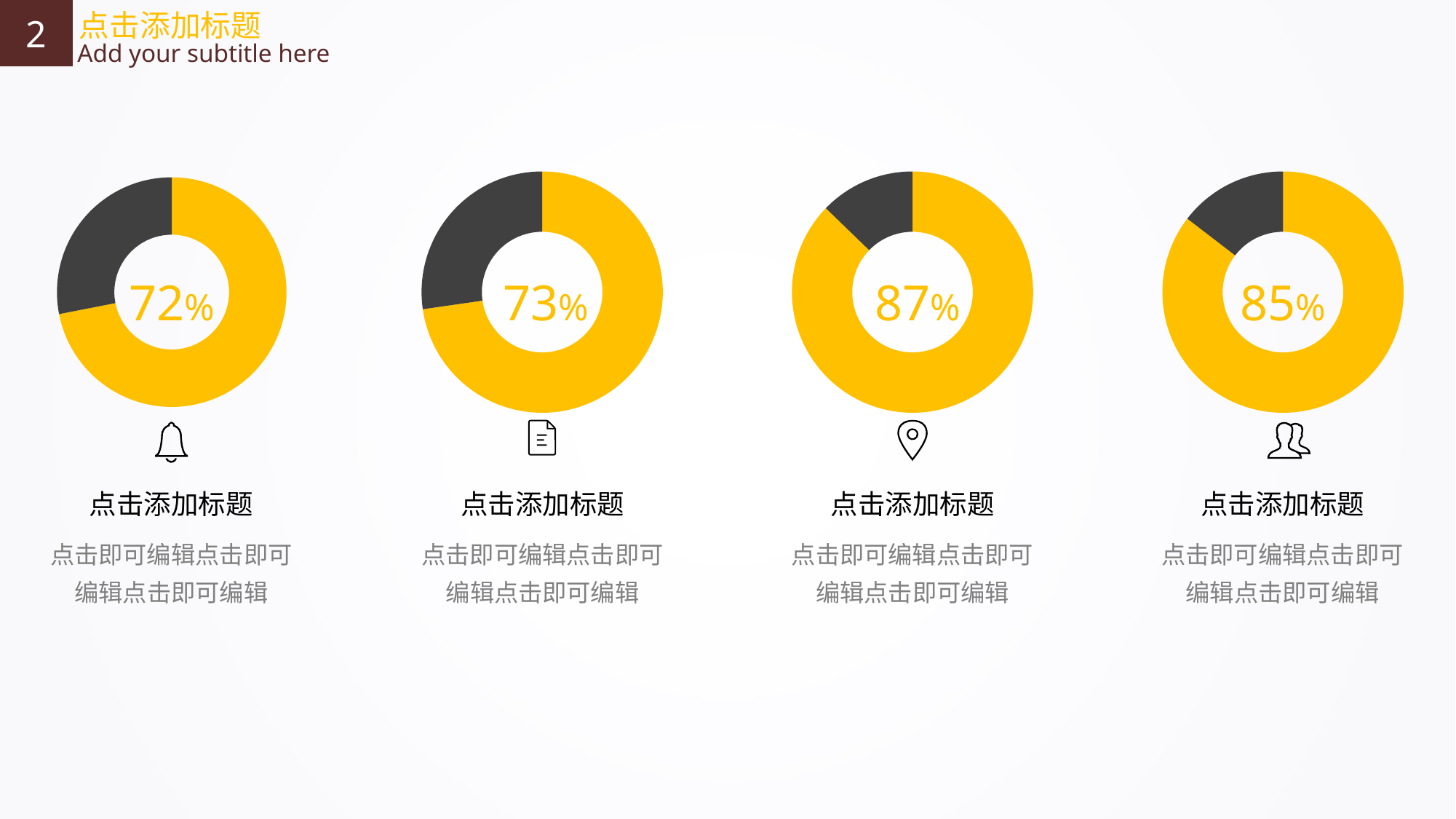
What is the difference between the percentage in the rightmost donut chart and the percentage in the second donut chart from the left? 12% Which donut chart shows the highest percentage? The third from the left (87%) In the leftmost donut chart, what share does the dark grey segment represent? 28% Which donut chart shows the lowest percentage? The leftmost (72%) What percentage is shown in the center of the third donut chart from the left? 87% What percentage is shown in the center of the rightmost donut chart? 85% What is the difference between the percentage in the third donut chart and the percentage in the leftmost donut chart? 15% What kind of chart is used on this slide? Donut (pie) chart Which is larger: the percentage in the third donut chart or the percentage in the rightmost donut chart? The third donut chart (87%) How many donut charts are on the slide? 4 What percentage is shown in the center of the second donut chart from the left? 73% What percentage is shown in the center of the leftmost donut chart? 72%